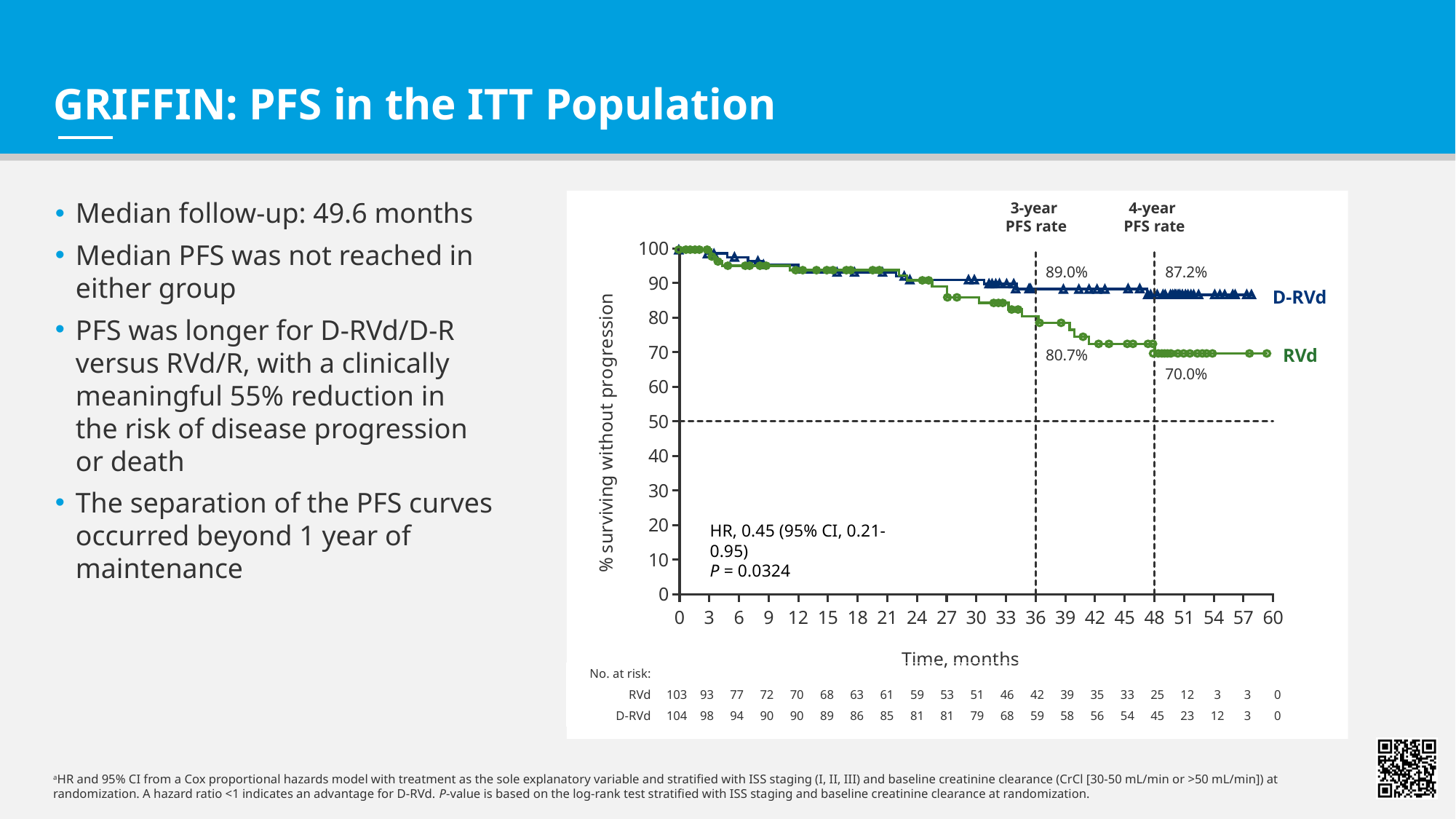
What is the 3-year PFS rate for the D-RVd group? 89.0% How many treatment groups (curves) are plotted on the chart? 2 How many patients were at risk in the RVd group at 0 months? 103 What is the 4-year PFS rate for the D-RVd group? 87.2% Which group has the higher 3-year PFS rate, D-RVd or RVd? D-RVd What hazard ratio is shown on the chart? 0.45 What is the difference between the 4-year PFS rates of D-RVd and RVd? 17.2 percentage points How many patients were at risk in the D-RVd group at 36 months? 59 Do the PFS curves rise or fall as time in months increases? fall Is the value of the RVd curve at 54 months greater or less than 60? greater What is the 4-year PFS rate for the RVd group? 70.0% What is the 3-year PFS rate for the RVd group? 80.7%